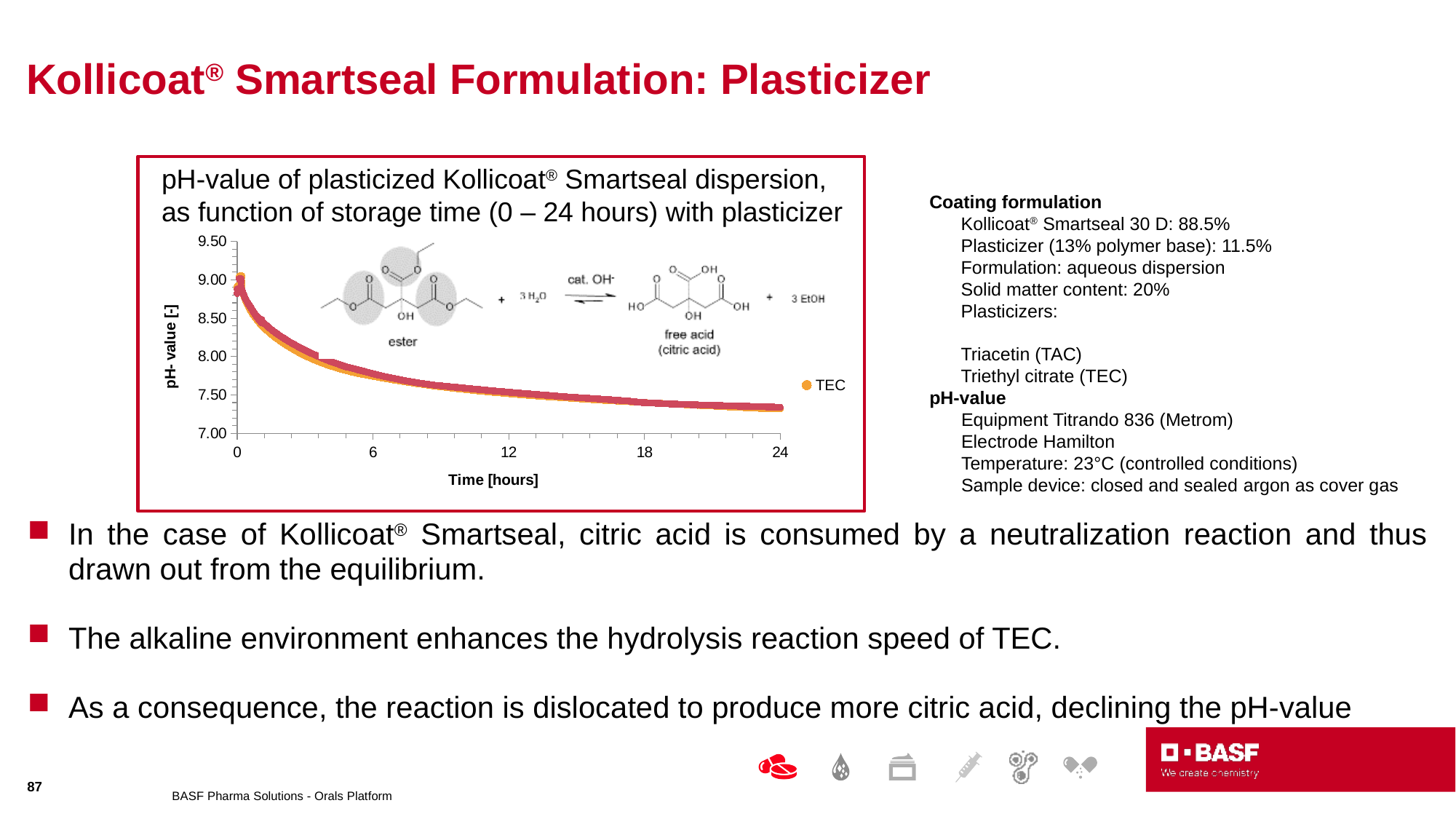
What is the name of the series shown in the chart legend? TEC At which storage time is the pH-value highest? 0 hours Which is larger, the pH-value at 0 hours or at 24 hours? 0 hours What is the label of the x axis of the chart? Time [hours] What kind of chart is shown on the slide? Scatter (line) chart Is the pH-value at 6 hours greater or less than 7.50? greater Does the pH-value rise or fall as storage time increases from 0 to 24 hours? Fall Is the pH-value at 24 hours greater or less than 7.50? less How many series does the chart legend list? 1 At which storage time is the pH-value lowest? 24 hours Is the pH-value at 6 hours greater or less than 8.50? less